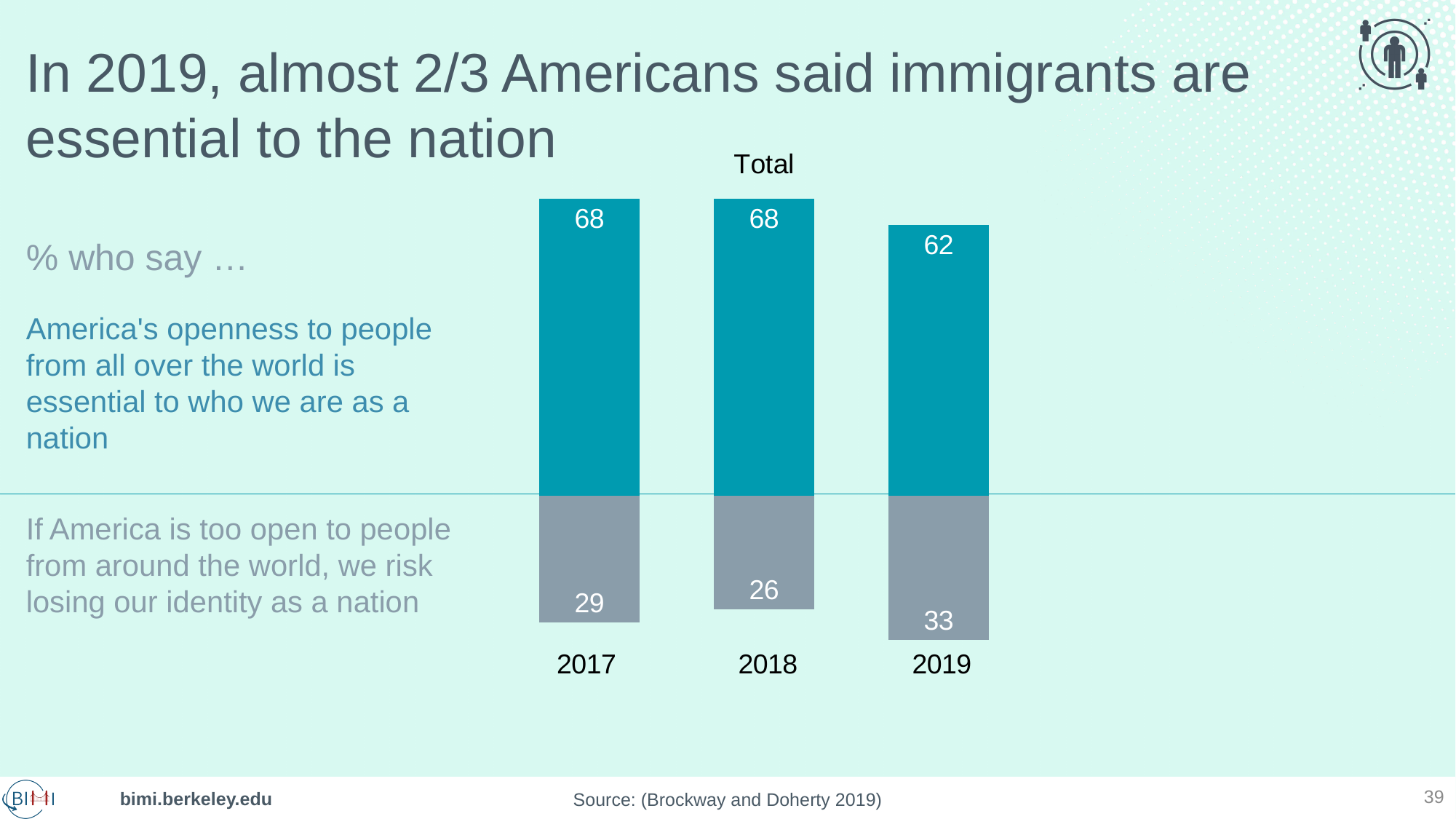
In which year was the share saying America is too open the highest? 2019 What kind of chart is shown on the slide? bar chart What is the title shown above the bars? Total How many years are shown on the chart? 3 What is the difference between the 2019 and 2018 values for those saying America is too open? 7 What percentage said America's openness is essential to who we are as a nation in 2017? 68 What percentage said America is too open and we risk losing our identity in 2018? 26 What percentage said America's openness is essential to who we are as a nation in 2019? 62 In which year was the share saying openness is essential the lowest? 2019 What is the difference between the 2017 and 2019 values for those saying openness is essential? 6 Which is larger: the 2019 value for 'openness is essential' or the 2019 value for 'too open'? openness is essential In which year was the share saying America is too open the lowest? 2018